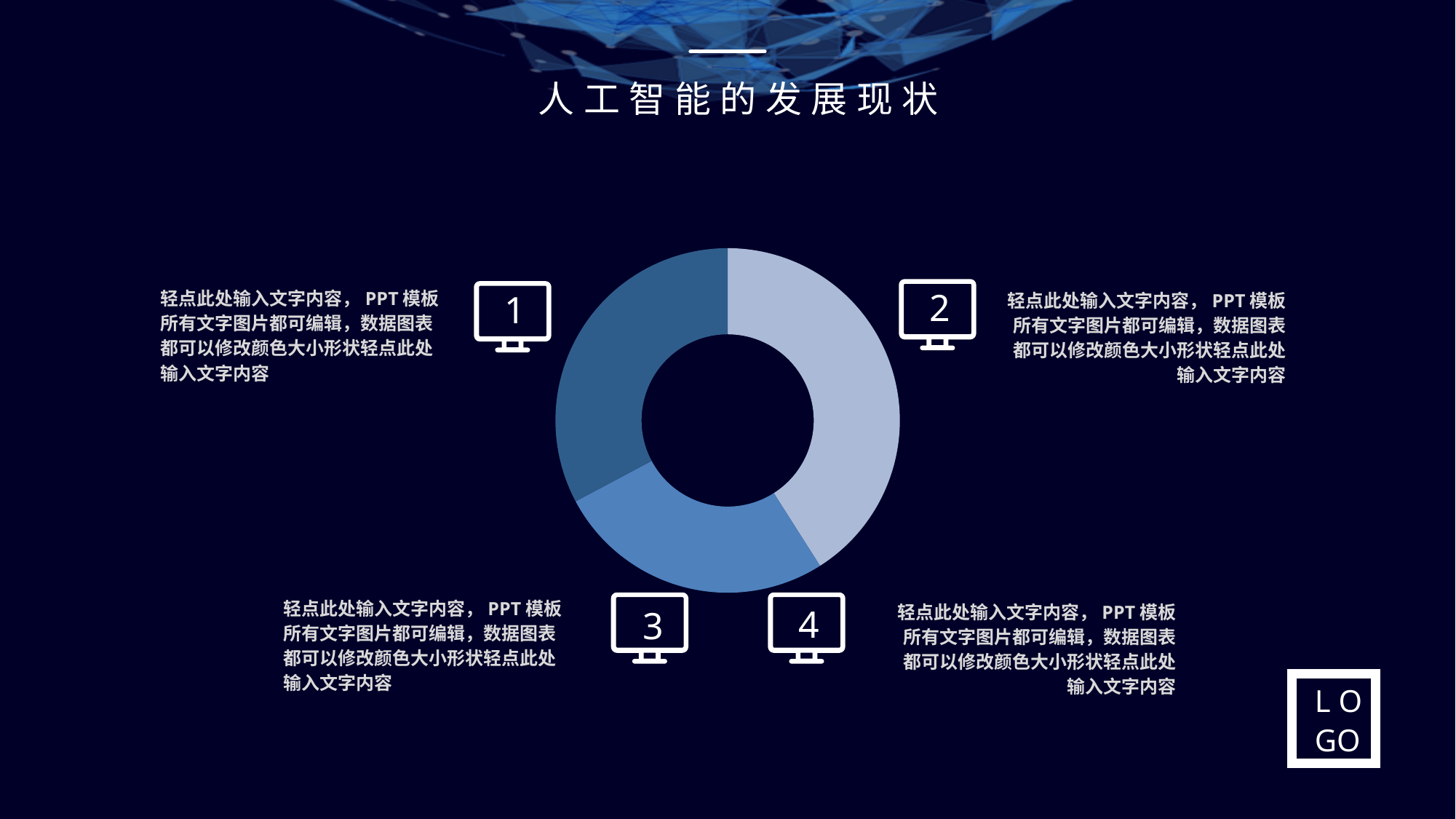
Which is larger, the dark blue slice or the medium blue slice? The dark blue slice Which is larger, the light blue slice or the medium blue slice? The light blue slice What is the title of the slide containing the doughnut chart? 人工智能的发展现状 What kind of chart is shown on the slide? Doughnut (pie) chart Which slice of the doughnut chart is the largest? The light blue slice Does the doughnut chart show any data labels with values? No How many slices does the doughnut chart have? 3 Which slice of the doughnut chart is the smallest? The medium blue slice